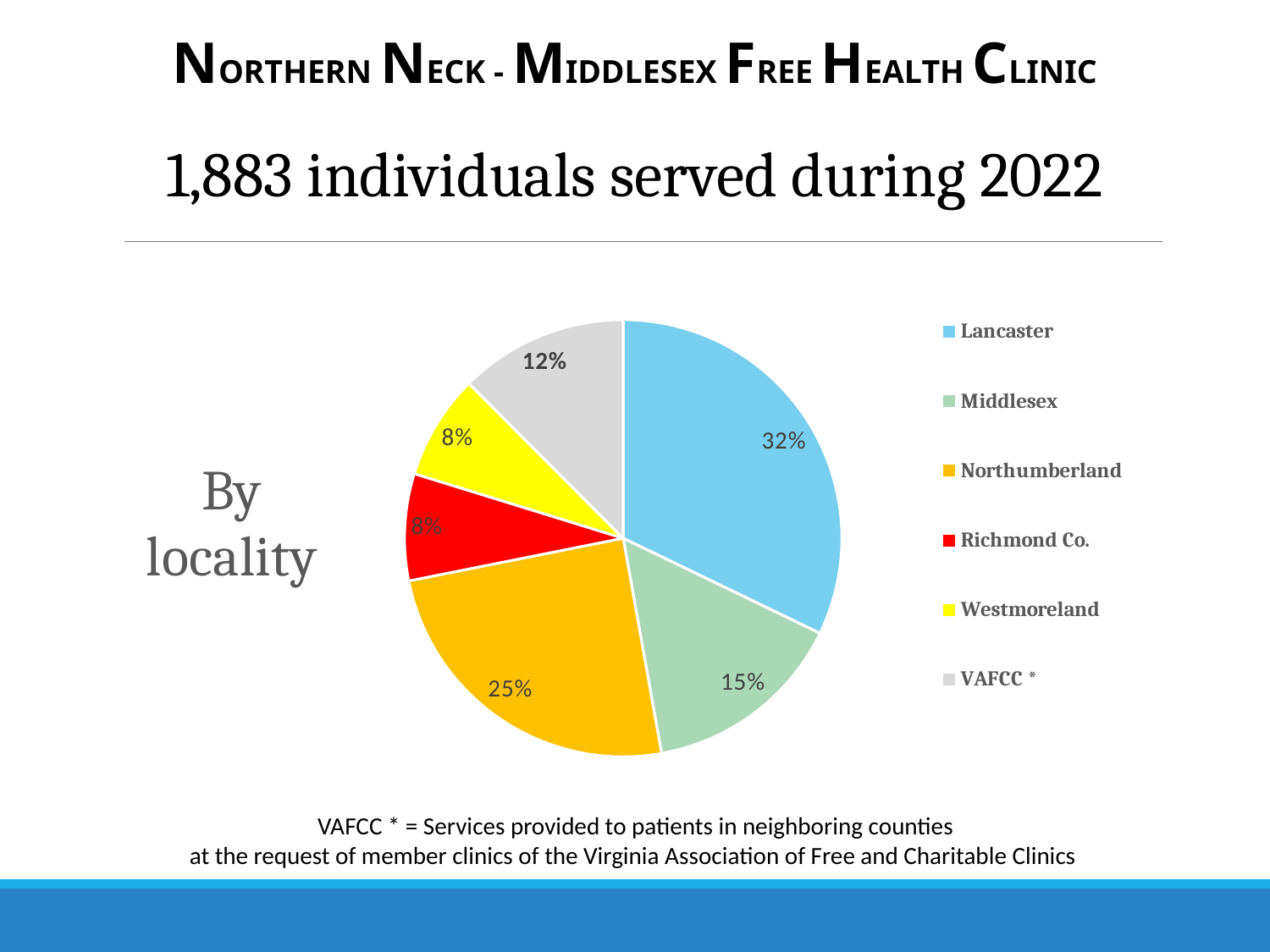
What percentage is shown for VAFCC *? 12% What share does Middlesex account for? 15% How many slices does the pie chart have? 6 How many entries does the legend list? 6 Which is larger, the share for Middlesex or the share for VAFCC *? Middlesex What kind of chart is shown on the slide? pie chart What share is shown for Richmond Co.? 8% What colour is the Westmoreland slice? yellow Which locality has the largest slice of the pie? Lancaster What is the difference in percentage points between Lancaster and Northumberland? 7 What share of individuals served came from Lancaster? 32% What percentage of the pie is Northumberland? 25%